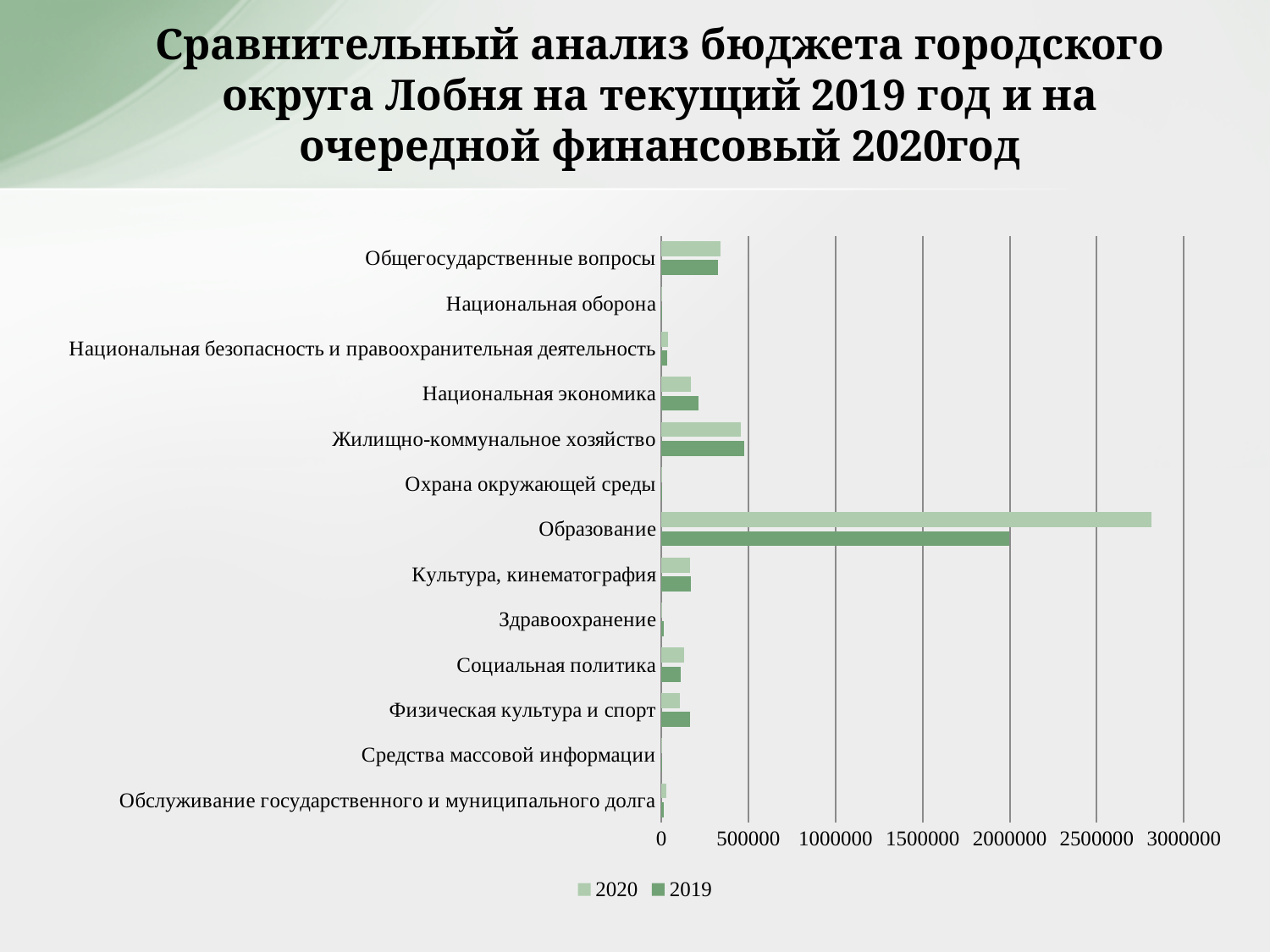
How many series does the legend list? 2 For Физическая культура и спорт, which series has the larger value, 2020 or 2019? 2019 Which series are listed in the legend? 2020 and 2019 Which category has the highest value for the 2020 series? Образование What kind of chart is shown on the slide? Bar chart Is the 2020 value for Общегосударственные вопросы greater or less than 500000? less For Образование, which series has the larger value, 2020 or 2019? 2020 Is the 2020 value for Образование greater or less than 2500000? greater Is the 2019 value for Образование greater or less than 1500000? greater Which category has the highest value for the 2019 series? Образование How many categories are shown on the vertical axis of the chart? 13